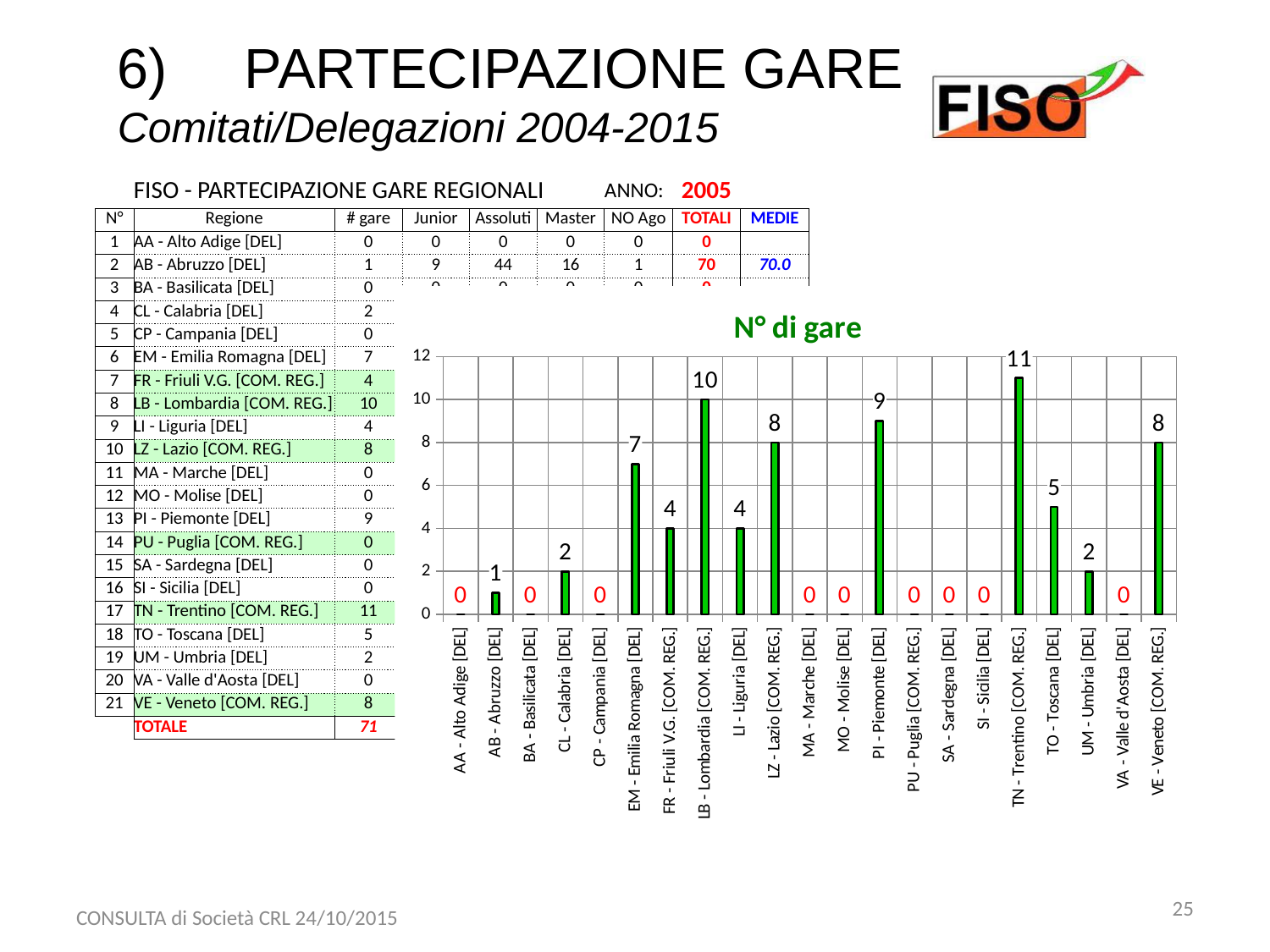
What is the title of the chart? N° di gare What is the difference between the values for VE - Veneto [COM. REG.] and UM - Umbria [DEL]? 6 Which is larger, the value for LZ - Lazio [COM. REG.] or the value for TO - Toscana [DEL]? LZ - Lazio [COM. REG.] What is the difference between the values for TN - Trentino [COM. REG.] and LB - Lombardia [COM. REG.]? 1 What is the value for AB - Abruzzo [DEL] in the chart? 1 What is the value for LB - Lombardia [COM. REG.] in the chart? 10 What type of chart is shown on the slide? bar chart What is the value for EM - Emilia Romagna [DEL] in the chart? 7 What is the value for PI - Piemonte [DEL] in the chart? 9 Which region has the highest value in the chart? TN - Trentino [COM. REG.] What is the value for TO - Toscana [DEL] in the chart? 5 How many categories (regions) are plotted on the x axis of the chart? 21